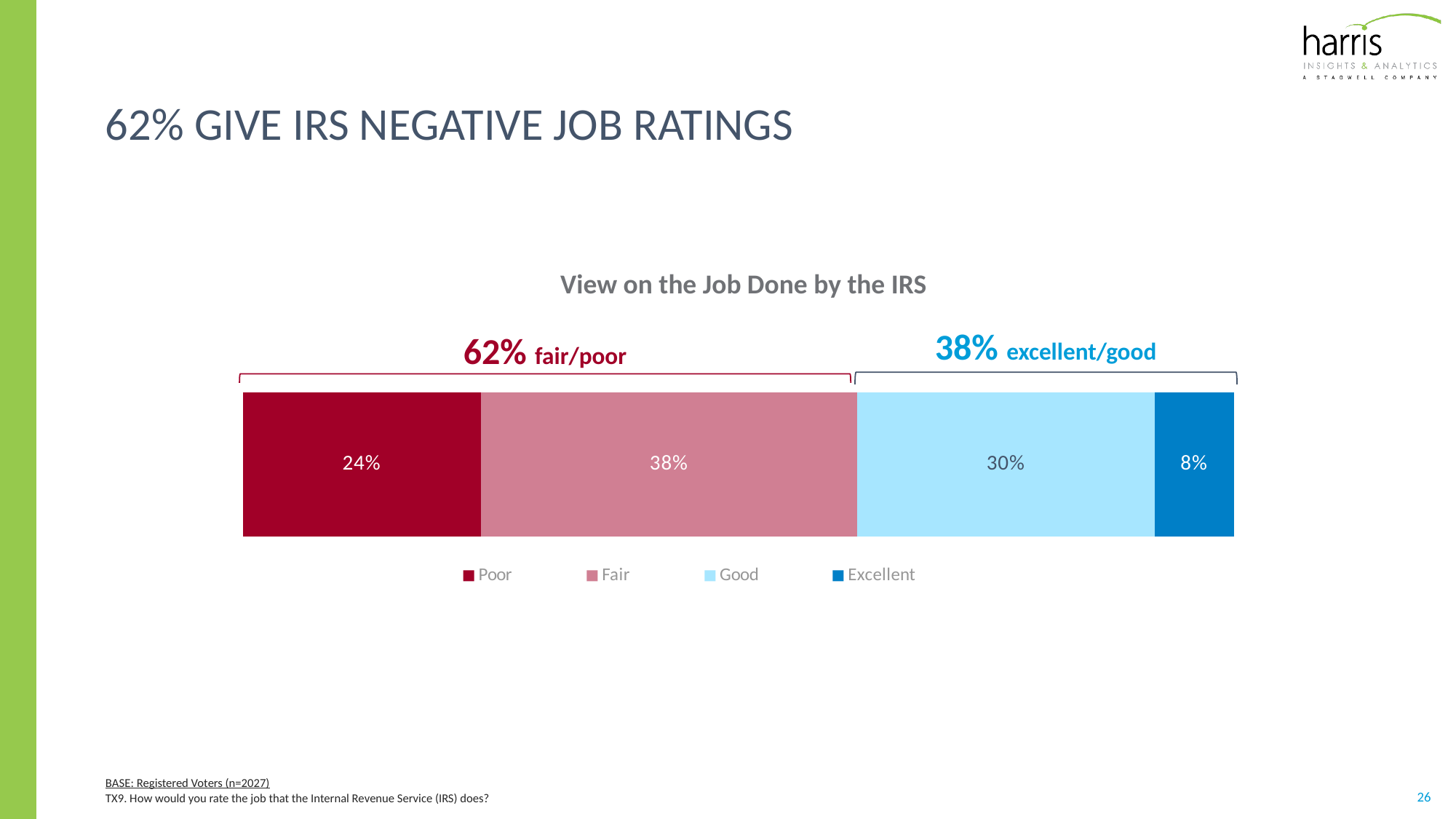
Which is larger, the share rating the IRS Poor or the share rating it Good? Good What percentage of respondents rated the job done by the IRS as Fair? 38% What is the combined percentage for the fair/poor ratings shown above the bar? 62% What is the combined percentage for the excellent/good ratings shown above the bar? 38% What is the difference in percentage points between the Good and Excellent ratings? 22 What is the title of the chart? View on the Job Done by the IRS How many rating categories does the legend list? 4 Which rating category has the largest share in the chart? Fair What percentage of respondents rated the job done by the IRS as Poor? 24% What percentage of respondents rated the job done by the IRS as Good? 30% Which rating category has the smallest share in the chart? Excellent What percentage of respondents rated the job done by the IRS as Excellent? 8%